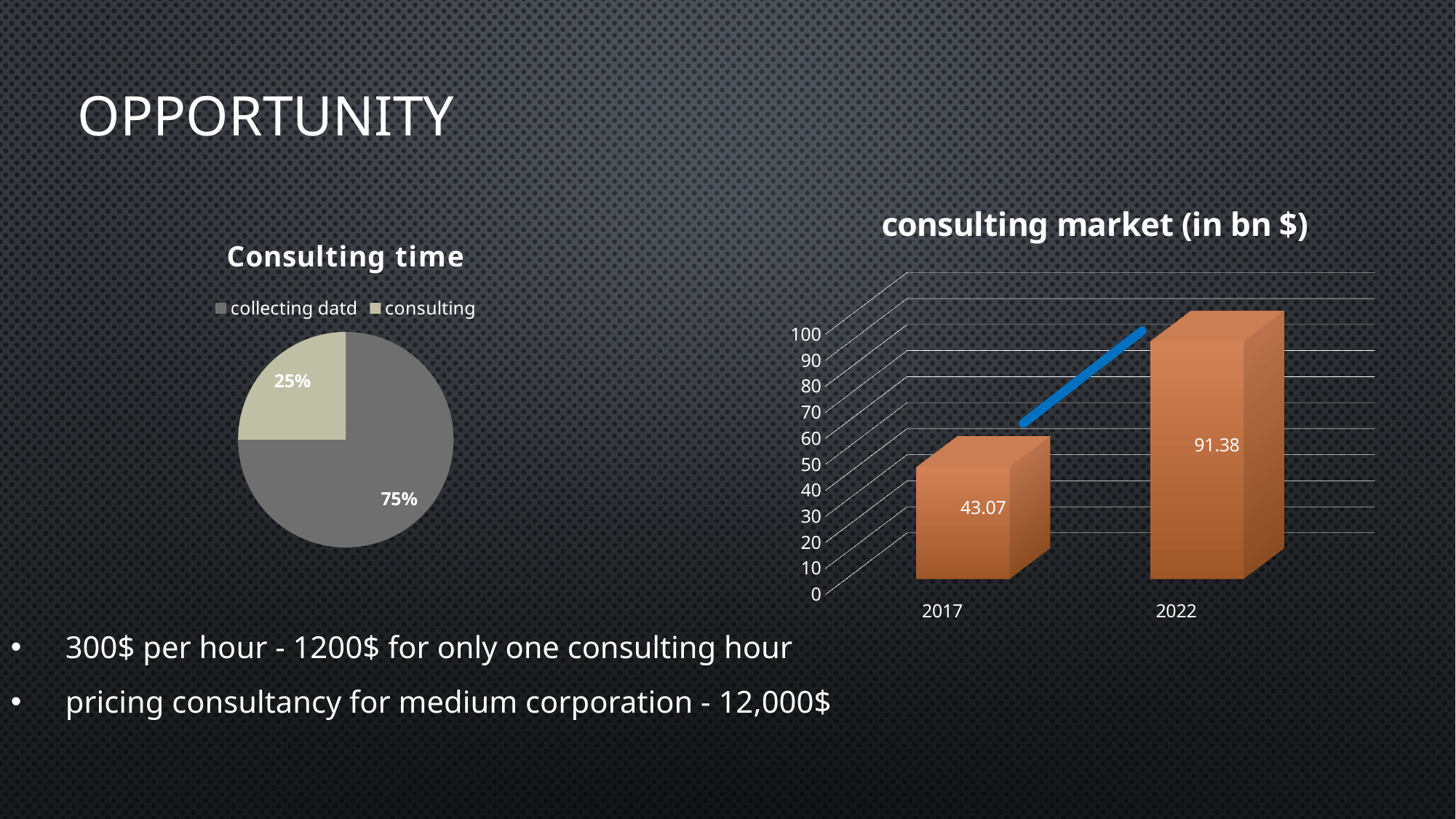
What kind of chart is the 'consulting market (in bn $)' chart? bar chart In the 'consulting market (in bn $)' chart, which year has the highest value? 2022 What kind of chart is the 'Consulting time' chart? pie chart In the 'consulting market (in bn $)' chart, what is the difference between the 2022 and 2017 values? 48.31 In the 'Consulting time' pie chart, which slice is larger, collecting datd or consulting? collecting datd In the 'consulting market (in bn $)' chart, what is the value for 2017? 43.07 In the 'consulting market (in bn $)' chart, what is the value for 2022? 91.38 In the 'consulting market (in bn $)' chart, how many categories are shown on the x axis? 2 In the 'Consulting time' pie chart, what share is labelled for collecting datd? 75% In the 'consulting market (in bn $)' chart, do the values rise or fall from 2017 to 2022? rise In the 'Consulting time' pie chart, what share is labelled for consulting? 25% How many entries does the legend of the 'Consulting time' pie chart list? 2